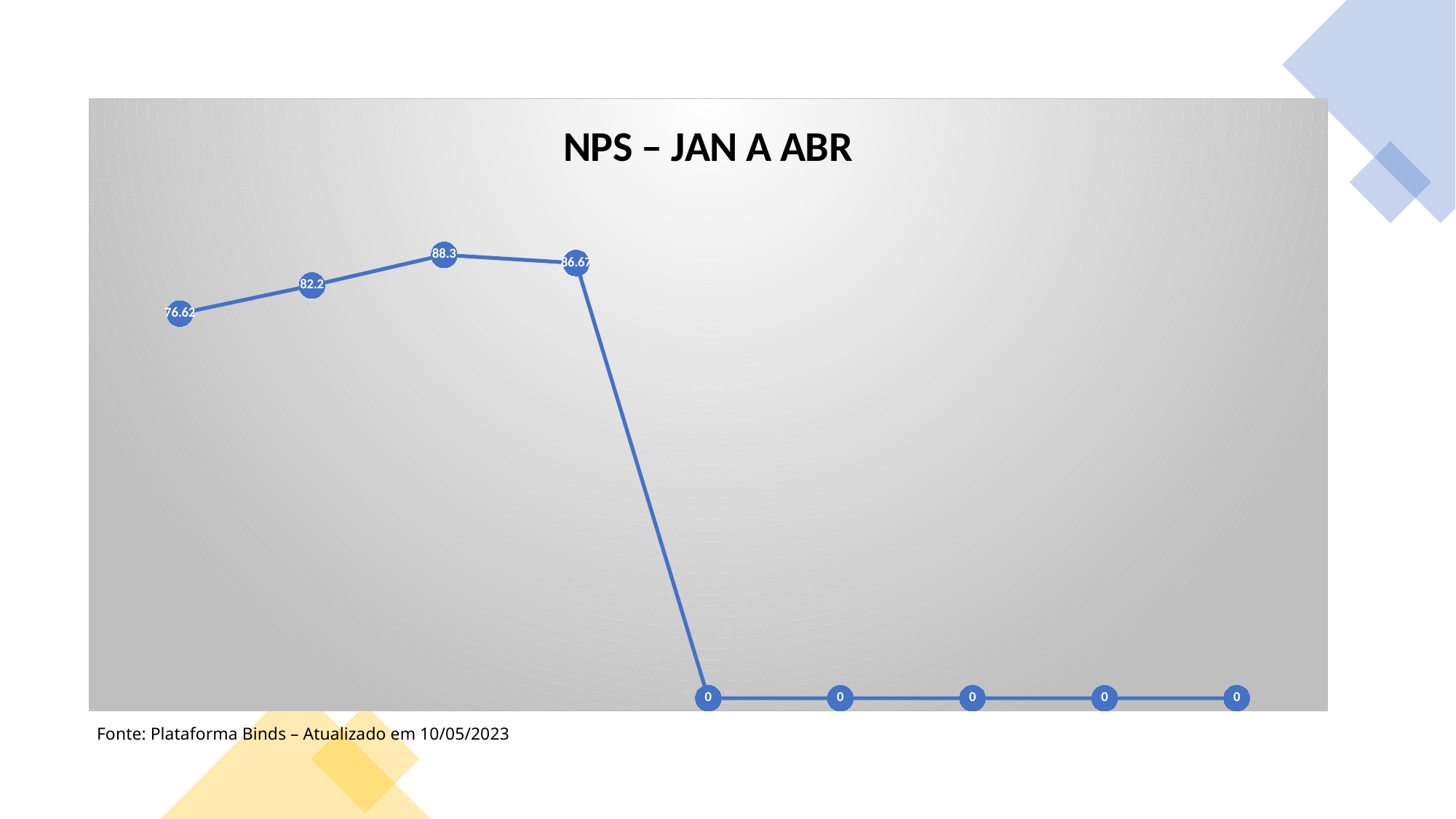
What is the value of the fourth data point on the line? 86.67 What is the value of the second data point on the line? 82.2 How many data points are plotted on the line? 9 What is the title of the chart? NPS – JAN A ABR What is the value of the first data point on the line? 76.62 Which is larger, the third data point or the fourth data point? the third data point (88.3) Do the values rise or fall across the first three data points? rise What kind of chart is shown on the slide? line chart What source is cited below the chart? Plataforma Binds – Atualizado em 10/05/2023 What is the value of the last five data points on the line? 0 What is the highest value plotted on the chart? 88.3 What is the difference between the third data point (88.3) and the first data point (76.62)? 11.68